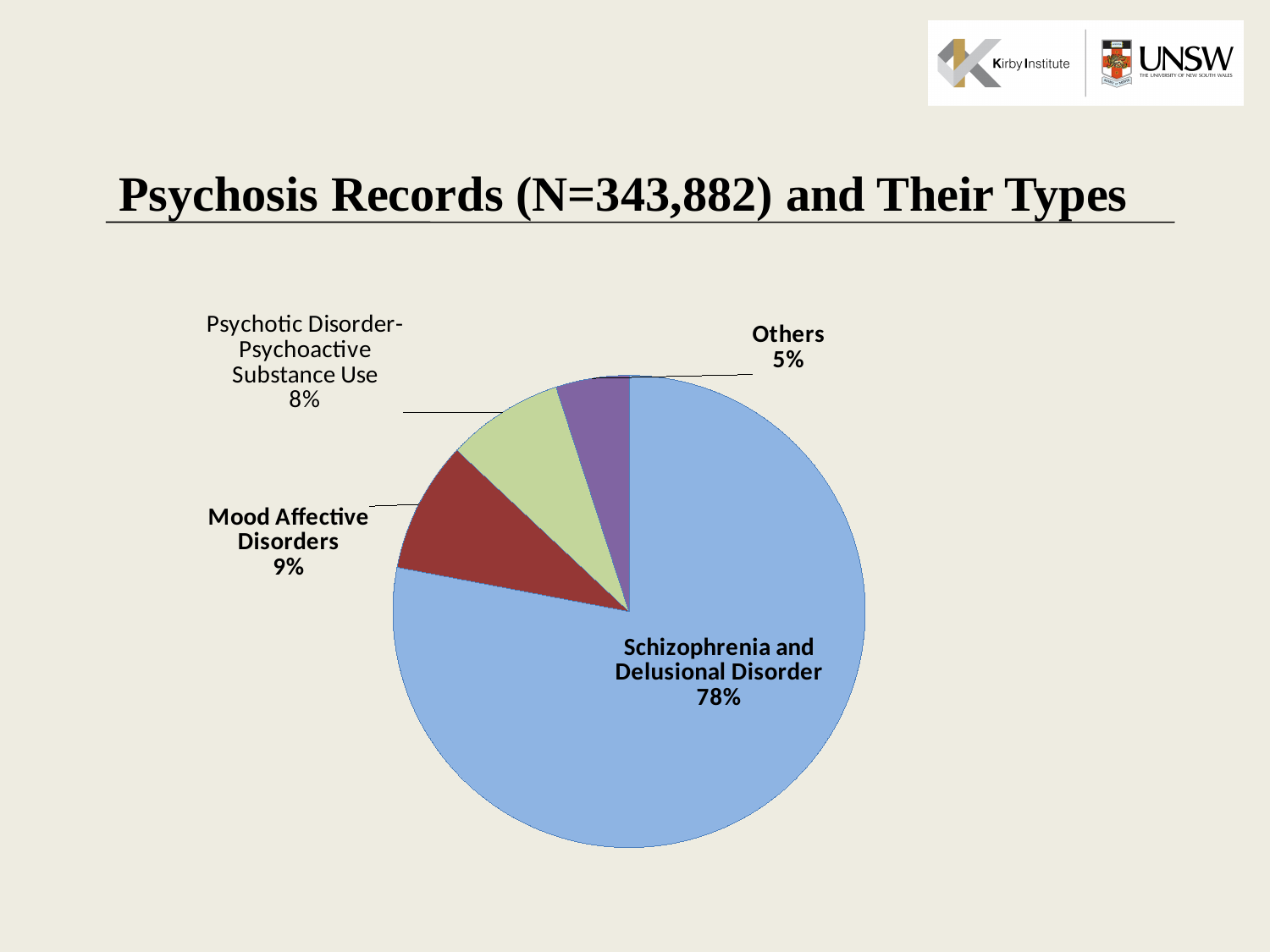
What share of psychosis records is Mood Affective Disorders? 9% What colour is the Mood Affective Disorders slice? Dark red What share of psychosis records is Schizophrenia and Delusional Disorder? 78% What is the title of the slide? Psychosis Records (N=343,882) and Their Types Which category has the largest slice of the pie? Schizophrenia and Delusional Disorder How many categories are shown in the pie chart? 4 What is the difference in percentage points between Schizophrenia and Delusional Disorder and Mood Affective Disorders? 69 percentage points What kind of chart is shown on the slide? Pie chart Which is larger: Mood Affective Disorders or Others? Mood Affective Disorders What share of psychosis records is Psychotic Disorder-Psychoactive Substance Use? 8% Which category has the smallest slice of the pie? Others